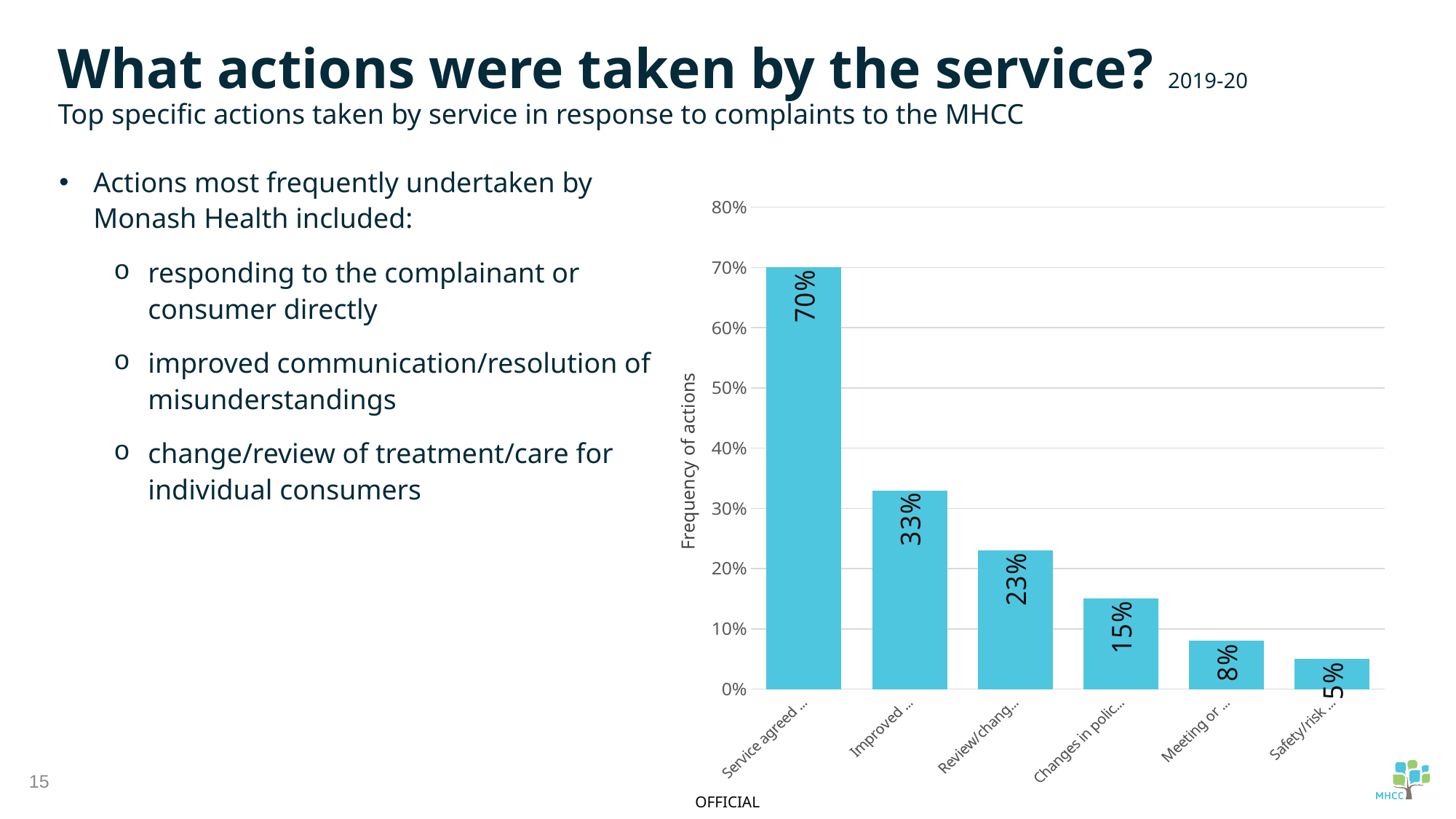
What is the value of the last (rightmost) bar, labelled "Safety/risk ..."? 5% How many bars are shown in the chart? 6 Do the bar values rise or fall from left to right along the x axis? Fall Which is larger: the bar labelled "Meeting or ..." or the bar labelled "Changes in polic..."? Changes in polic... What is the value of the bar labelled "Changes in polic..."? 15% What is the difference between the first bar (70%) and the second bar (33%)? 37% What type of chart is shown on the slide? Bar chart What is the value of the bar labelled "Review/chang..."? 23% Which bar has the highest value? Service agreed ... (70%) What is the label of the vertical axis of the chart? Frequency of actions Which bar has the lowest value? Safety/risk ... (5%) What is the value of the first (leftmost) bar, labelled "Service agreed ..."? 70%